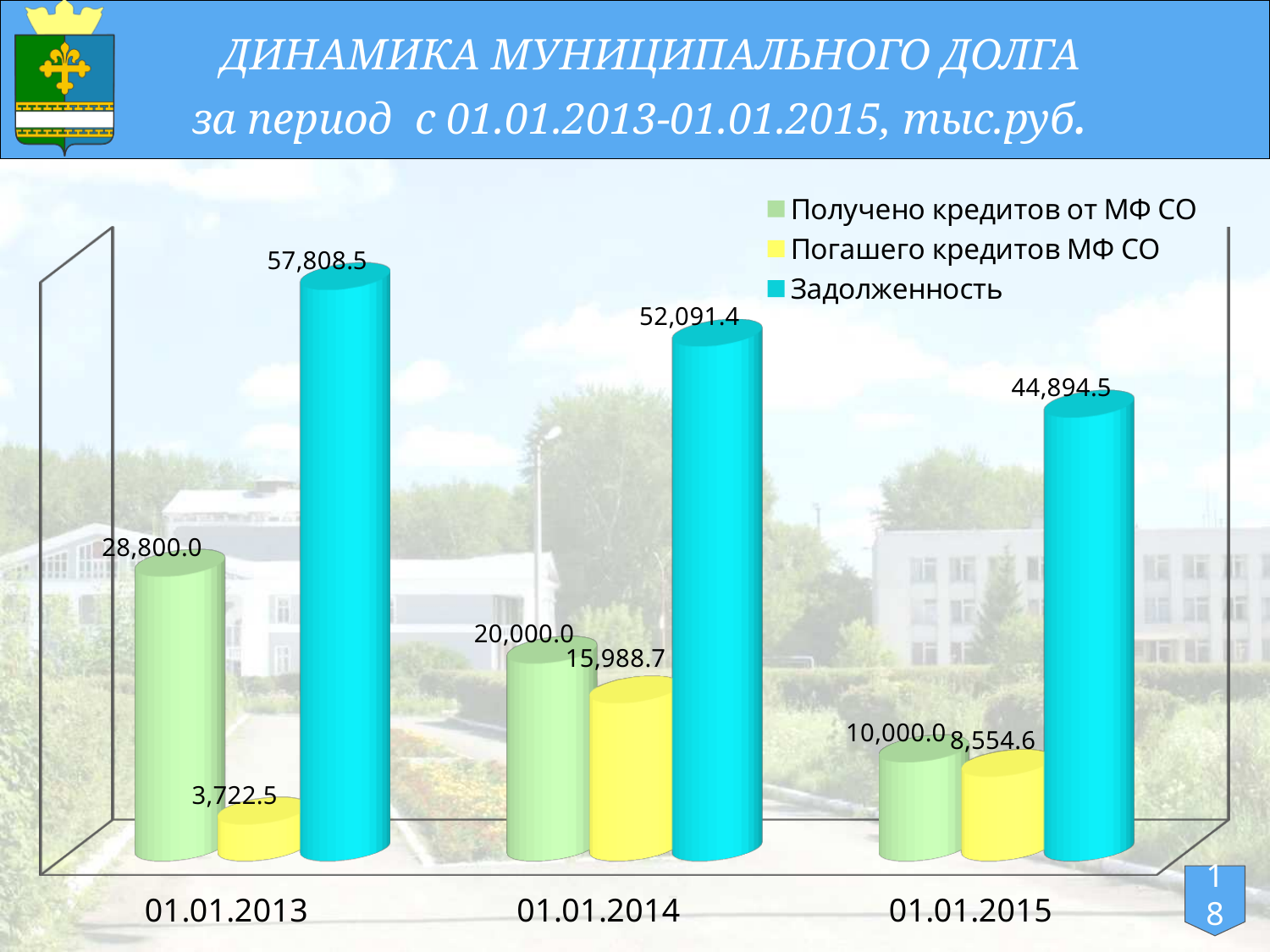
What is the value of Погашего кредитов МФ СО on 01.01.2015? 8,554.6 How many dates are shown on the x axis? 3 Does Задолженность rise or fall from 01.01.2013 to 01.01.2015? Fall What kind of chart is shown on the slide? Bar chart On which date is Задолженность the highest? 01.01.2013 Which is larger on 01.01.2014: Получено кредитов от МФ СО or Погашего кредитов МФ СО? Получено кредитов от МФ СО What is the value of Задолженность on 01.01.2013? 57,808.5 What is the value of Получено кредитов от МФ СО on 01.01.2014? 20,000.0 On which date is Получено кредитов от МФ СО the lowest? 01.01.2015 What is the value of Погашего кредитов МФ СО on 01.01.2013? 3,722.5 How many series does the legend list? 3 What is the difference between Задолженность on 01.01.2013 and on 01.01.2015? 12,914.0